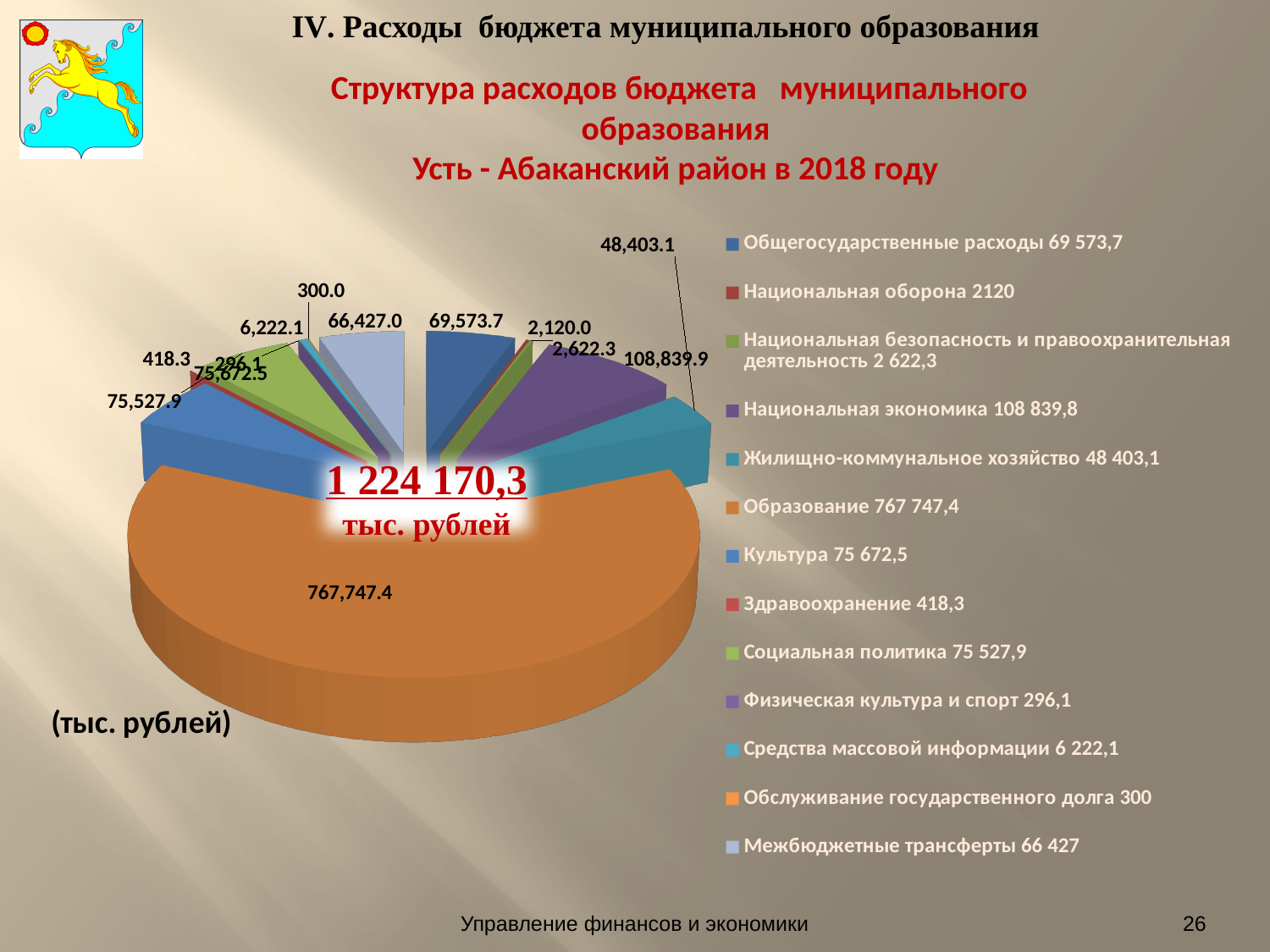
What is the value for Здравоохранение on the pie chart? 418.3 What is the title of the chart on the slide? Структура расходов бюджета муниципального образования Усть - Абаканский район в 2018 году What type of chart is shown on the slide? pie chart How many categories (slices) does the pie chart have? 13 Which category has the smallest value on the pie chart? Физическая культура и спорт What is the difference between the values for Общегосударственные расходы and Межбюджетные трансферты? 3,146.7 What is the value for Жилищно-коммунальное хозяйство on the pie chart? 48,403.1 Which category has the largest slice of the pie chart? Образование What is the value for Национальная экономика shown as a data label on the pie chart? 108,839.9 Which is larger, the value for Культура or the value for Социальная политика? Культура What total amount is printed in the centre of the pie chart? 1 224 170,3 тыс. рублей What is the value for Образование on the pie chart? 767,747.4